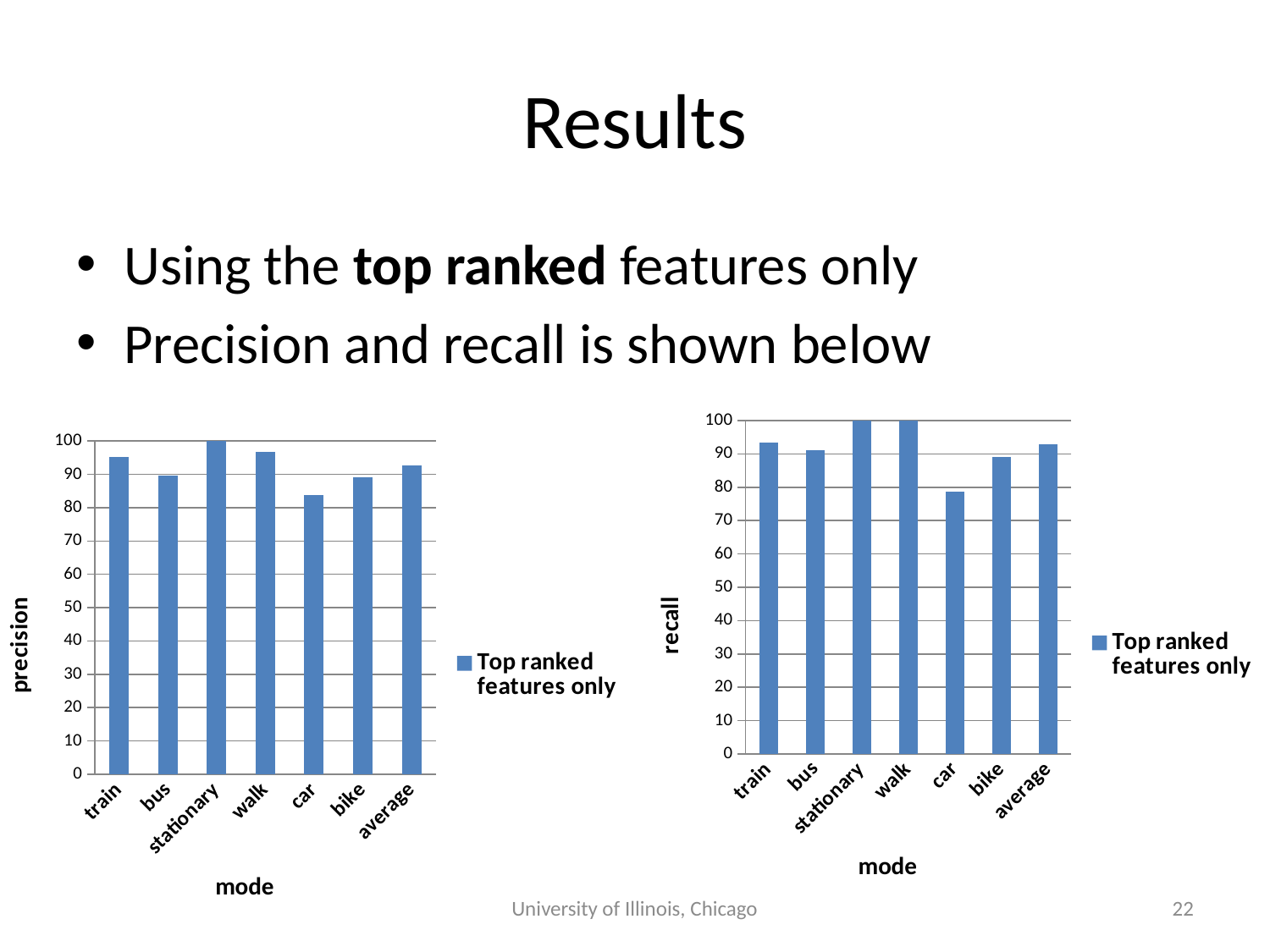
In the left chart (precision), is the value for car greater or less than 80? greater How many series does the legend of the left chart (precision) list? 1 What kind of chart is the left chart (precision)? bar chart How many categories are shown on the x axis of the right chart (recall)? 7 What is the legend entry shown for the right chart (recall)? Top ranked features only In the left chart (precision), which is larger, the value for stationary or the value for bus? stationary In the right chart (recall), is the value for car greater or less than 80? less In the right chart (recall), which is larger, the value for walk or the value for car? walk In the left chart (precision), which mode has the lowest precision? car In the right chart (recall), which mode has the lowest recall? car In the left chart (precision), is the value for walk greater or less than 90? greater